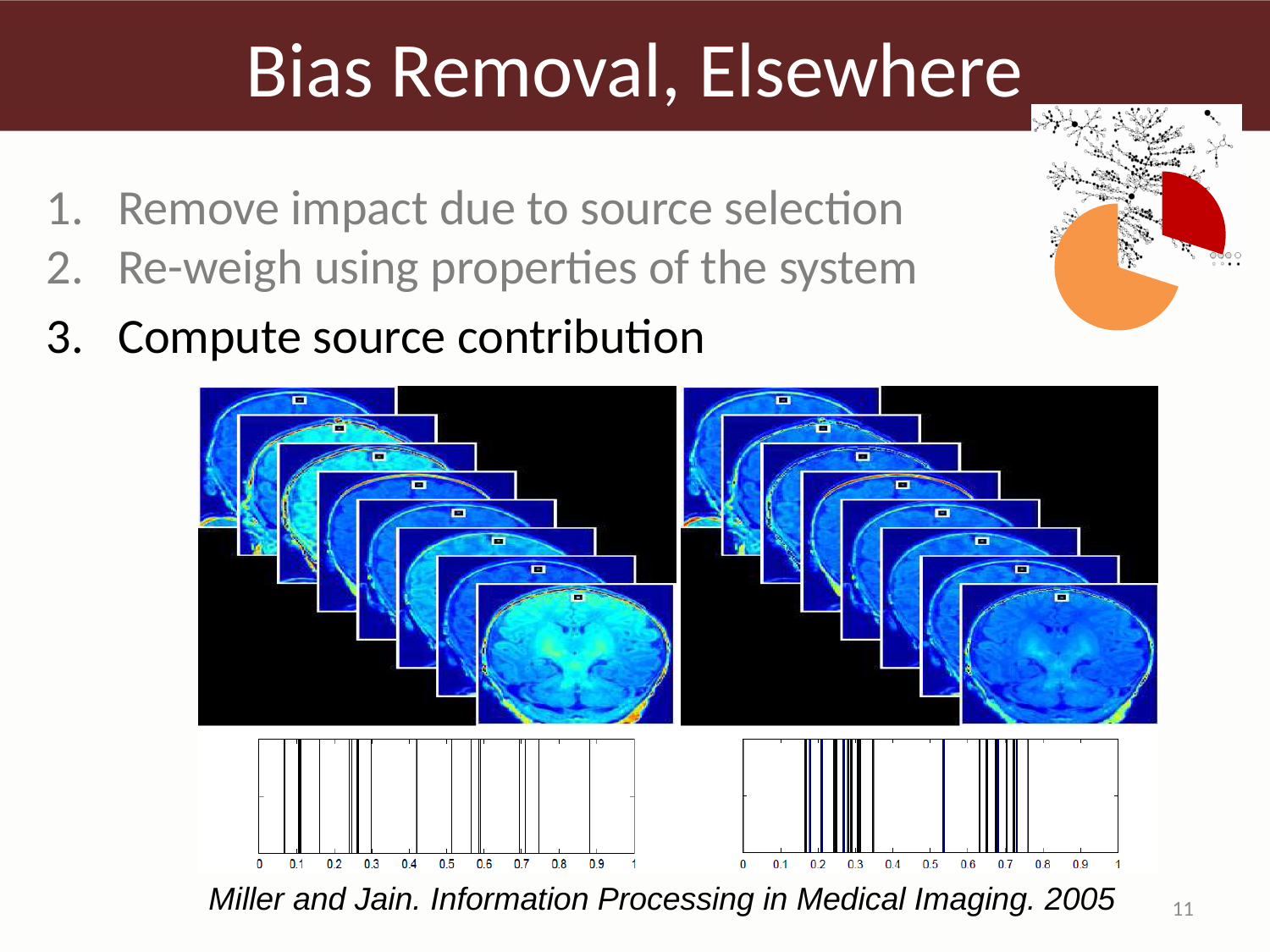
What kind of chart is shown in the top-right corner of the slide? pie chart In the bottom-right chart, is the leftmost vertical line at a value greater or less than 0.1? greater In the bottom-left chart, how many tick labels are printed along the x axis? 11 How many slices does the pie chart in the top-right corner have? 2 In the pie chart in the top-right corner, which slice is larger, the orange one or the dark red one? the orange one In the bottom-left chart, what is the lowest value labelled on the x axis? 0 In the bottom-right chart, what is the highest value labelled on the x axis? 1 In the bottom-left chart, is the rightmost vertical line at a value greater or less than 0.8? greater In the bottom-right chart, is the rightmost vertical line at a value greater or less than 0.8? less